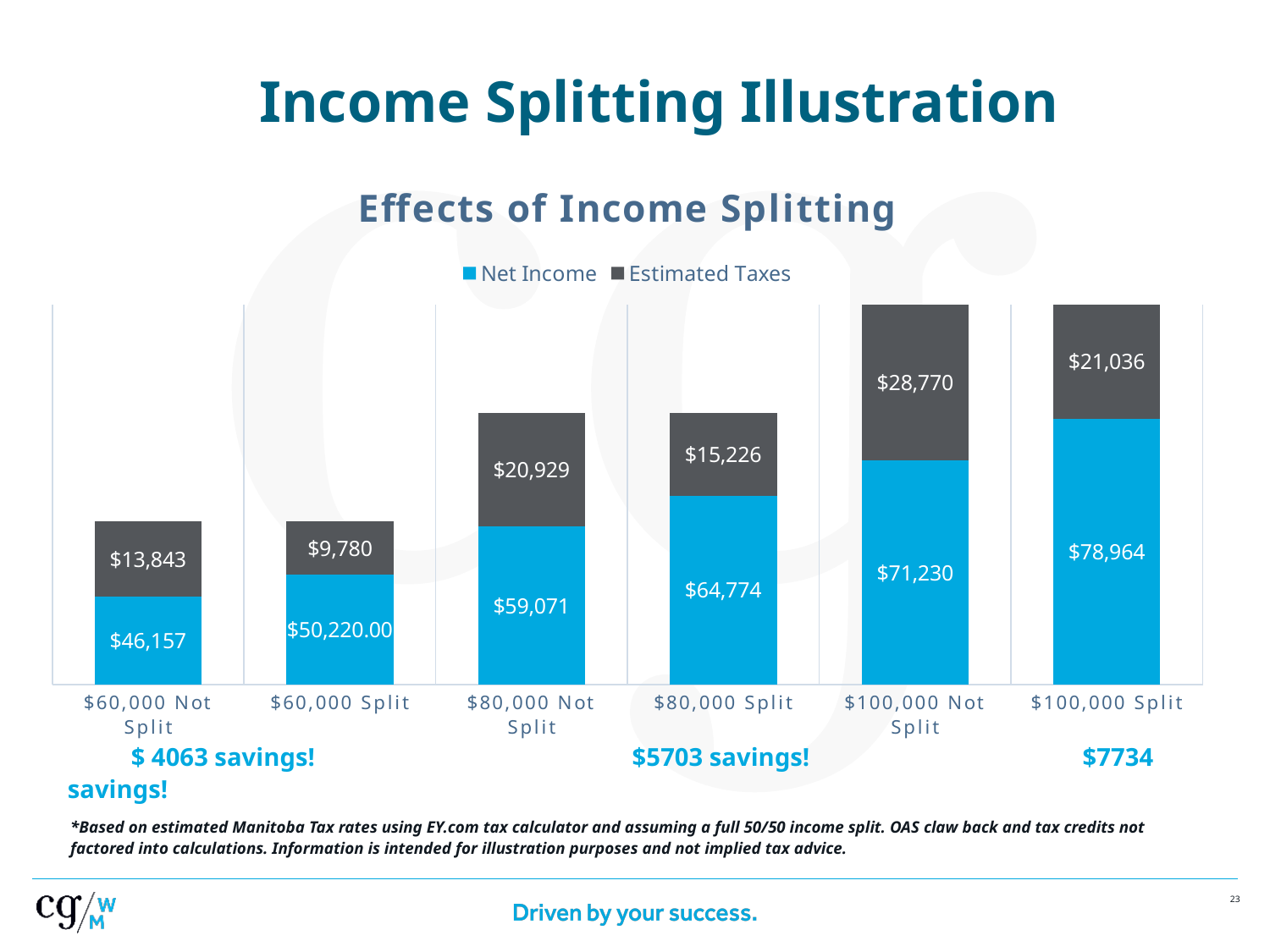
What is the title of the chart? Effects of Income Splitting How many categories are shown on the x axis? 6 How many series does the legend list? 2 Which is larger: the Net Income for $100,000 Split or the Net Income for $100,000 Not Split? $100,000 Split What is the Estimated Taxes value for the $100,000 Not Split category? $28,770 What is the Net Income value for the $80,000 Split category? $64,774 Which category has the highest Estimated Taxes value? $100,000 Not Split Which category has the lowest Net Income value? $60,000 Not Split What is the total of the stacked bar for $60,000 Not Split? $60,000 What kind of chart is shown on the slide? Stacked bar chart What is the Net Income value for the $60,000 Split category? $50,220.00 What is the difference in Estimated Taxes between $80,000 Not Split and $80,000 Split? $5,703